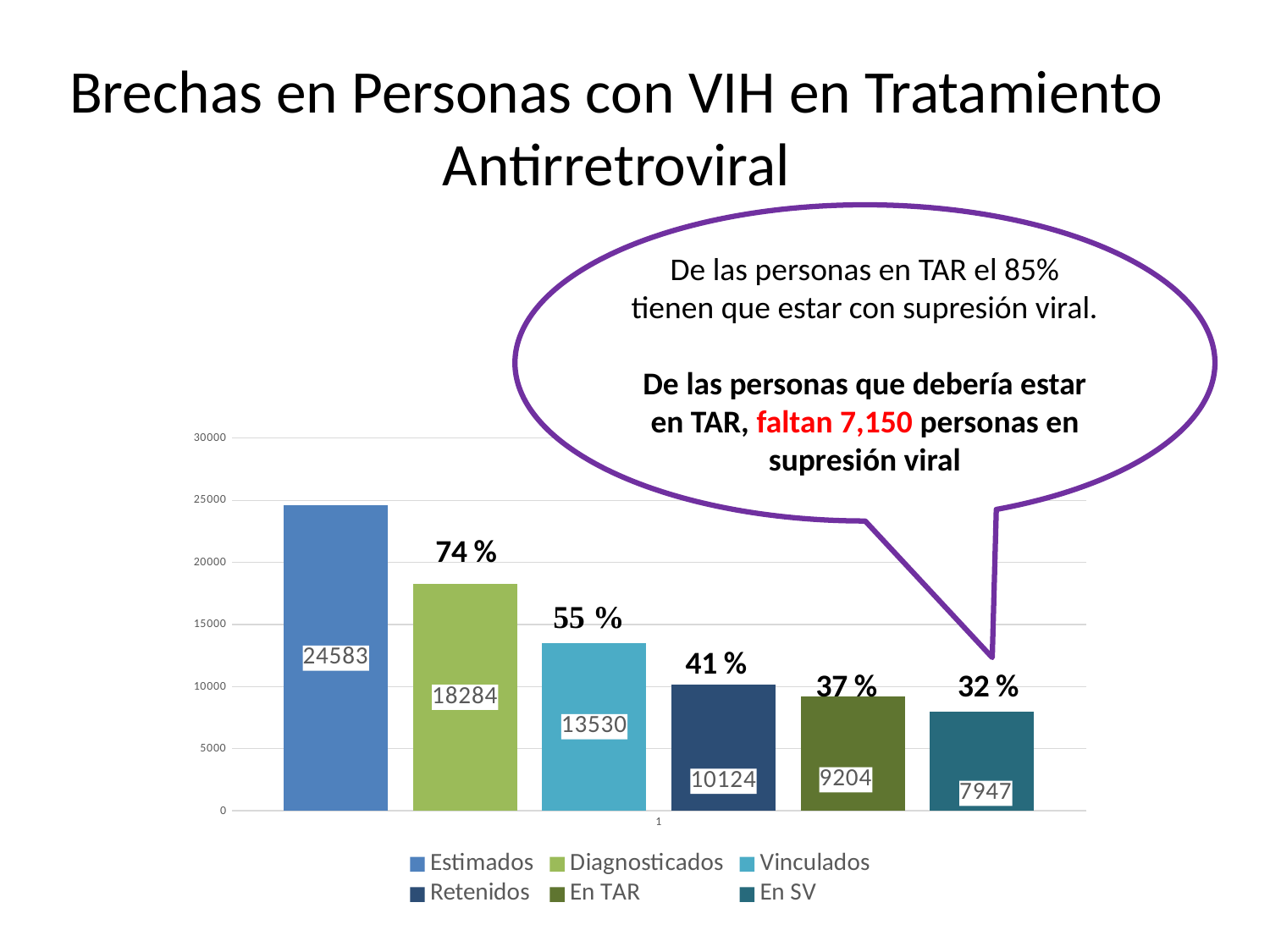
How many series does the legend list? 6 Which is larger, En TAR or En SV? En TAR What kind of chart is shown? bar chart What is the value for Diagnosticados? 18284 What percentage is shown above the En TAR bar? 37 % Is the value for Diagnosticados greater or less than 15000? greater What is the value for En SV? 7947 What is the value for Estimados? 24583 What is the value for Retenidos? 10124 What is the difference between Vinculados and Retenidos? 3406 Which series has the highest value? Estimados Which series has the lowest value? En SV